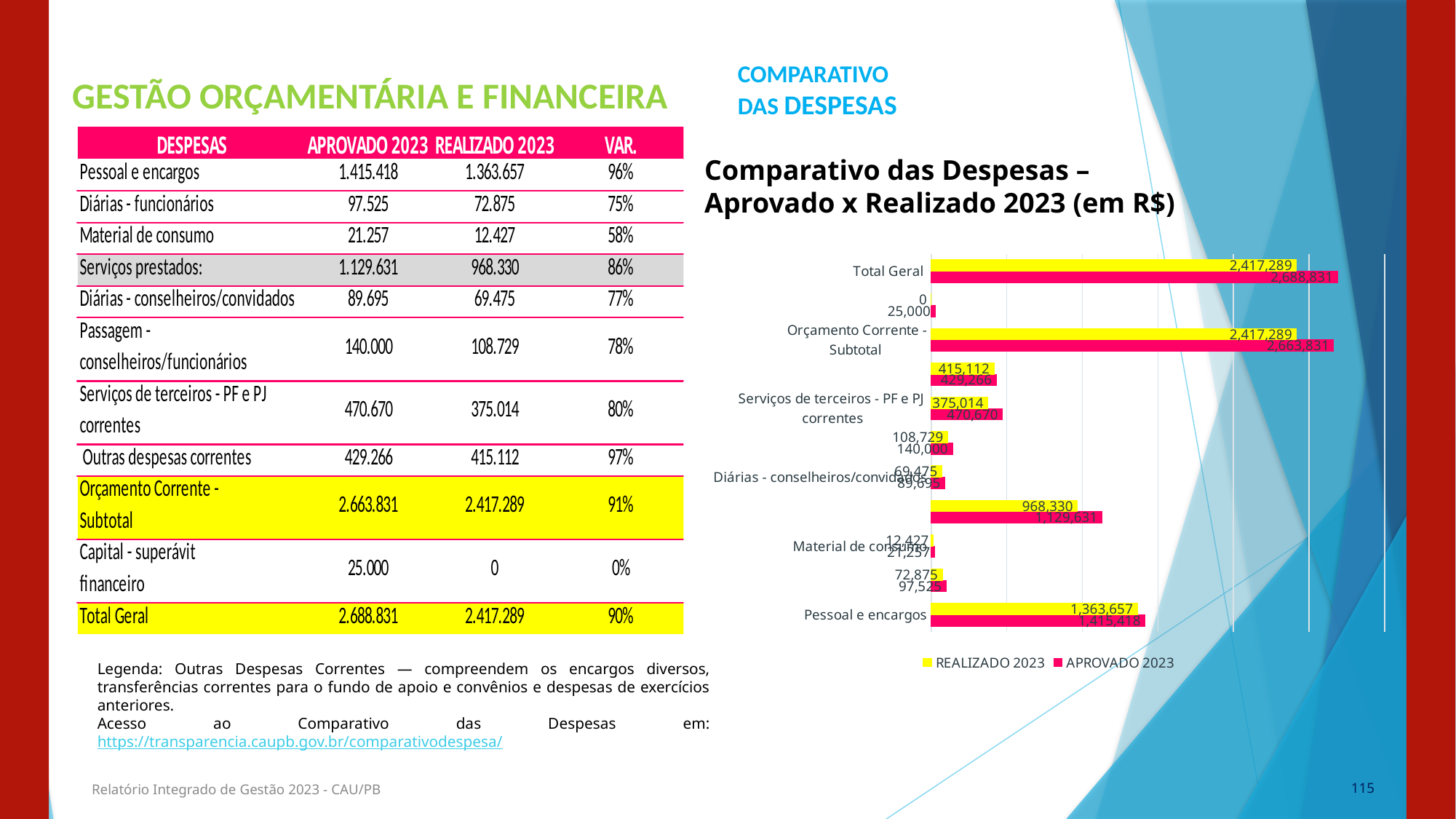
What is the difference between the APROVADO 2023 and REALIZADO 2023 values for Total Geral in the chart? 271,542 Among the labelled categories excluding the subtotal and total, which has the highest APROVADO 2023 value in the chart? Pessoal e encargos What type of chart is shown on the slide? bar chart What is the REALIZADO 2023 value for Material de consumo in the chart? 12,427 Which series does the yellow colour represent in the chart? REALIZADO 2023 What is the APROVADO 2023 value for Orçamento Corrente - Subtotal in the chart? 2,663,831 How many series does the chart legend list? 2 What is the APROVADO 2023 value for Serviços de terceiros - PF e PJ correntes in the chart? 470,670 For Pessoal e encargos, which is larger in the chart: APROVADO 2023 or REALIZADO 2023? APROVADO 2023 What is the APROVADO 2023 value for Total Geral in the chart? 2,688,831 What is the REALIZADO 2023 value for Pessoal e encargos in the chart? 1,363,657 What is the REALIZADO 2023 value for Total Geral in the chart? 2,417,289